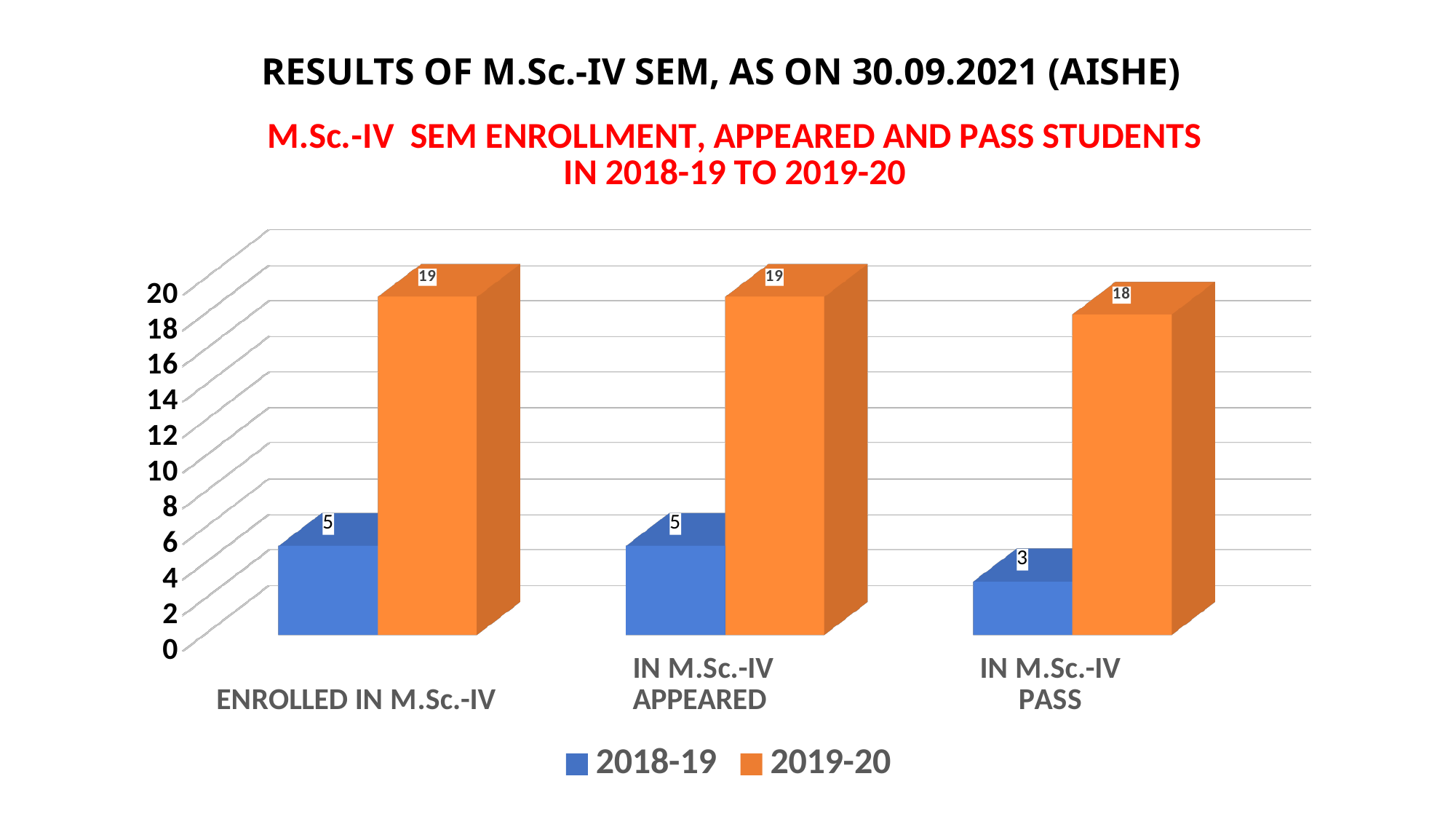
What is the value for 2018-19 in the IN M.Sc.-IV PASS category? 3 What is the value for 2019-20 in the IN M.Sc.-IV PASS category? 18 What kind of chart is shown on the slide? Bar chart How many categories are shown on the x axis? 3 What is the value for 2019-20 in the ENROLLED IN M.Sc.-IV category? 19 Which category has the lowest value for the 2018-19 series? IN M.Sc.-IV PASS What is the difference between the 2019-20 and 2018-19 values in the ENROLLED IN M.Sc.-IV category? 14 Which category has the lowest value for the 2019-20 series? IN M.Sc.-IV PASS How many series does the legend list? 2 Which series has the larger value in the IN M.Sc.-IV APPEARED category, 2018-19 or 2019-20? 2019-20 What is the difference between the 2019-20 and 2018-19 values in the IN M.Sc.-IV PASS category? 15 What is the value for 2018-19 in the IN M.Sc.-IV APPEARED category? 5